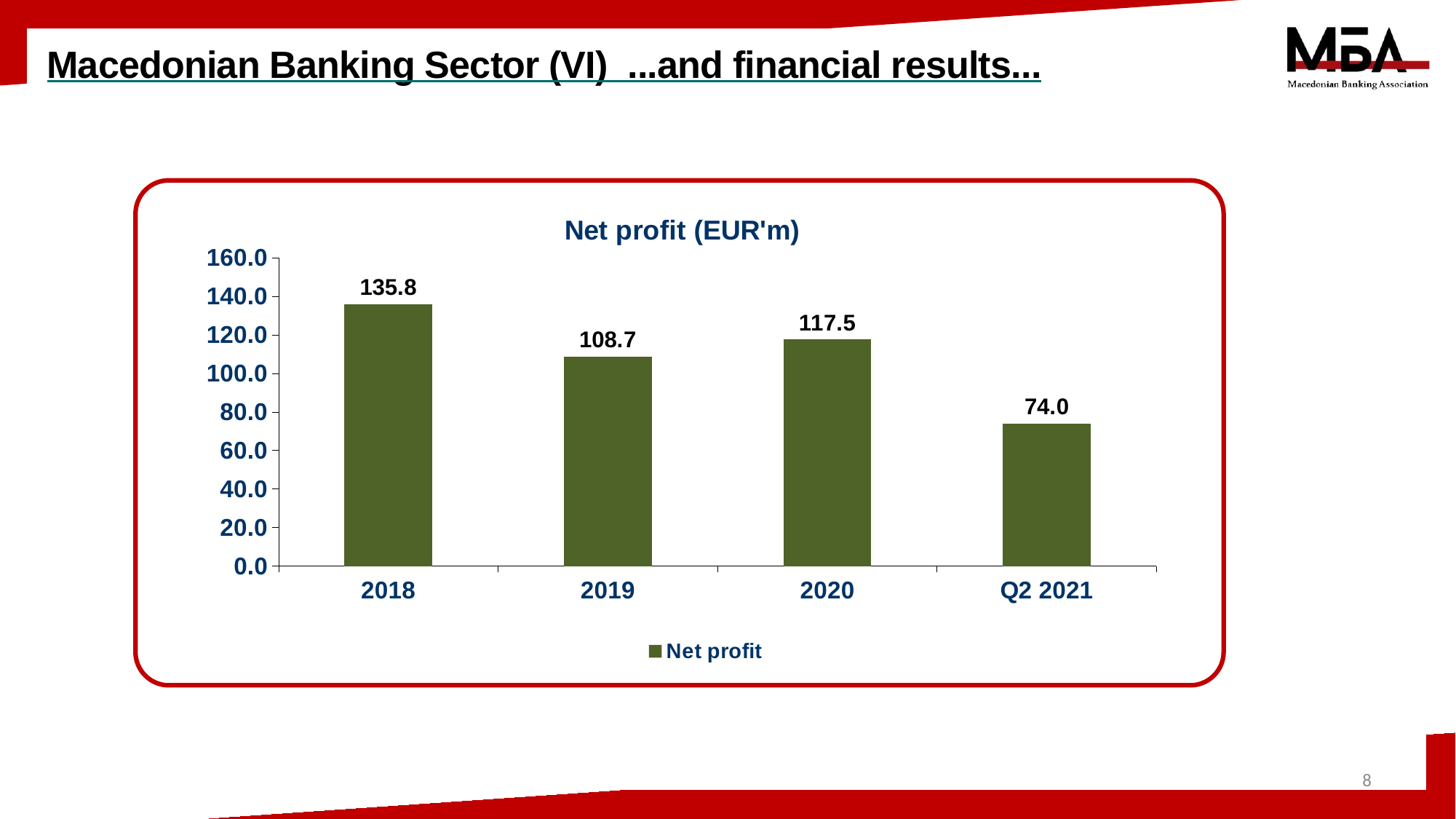
What is the net profit for 2018? 135.8 What is the net profit for Q2 2021? 74.0 What is the difference in net profit between 2020 and Q2 2021? 43.5 Which is larger, the net profit for 2019 or for 2020? 2020 What is the difference in net profit between 2018 and 2019? 27.1 Which period has the highest net profit? 2018 What is the title of the chart? Net profit (EUR'm) What is the net profit for 2019? 108.7 How many periods are shown on the x axis? 4 Which period has the lowest net profit? Q2 2021 What kind of chart is shown on the slide? bar chart What is the net profit for 2020? 117.5